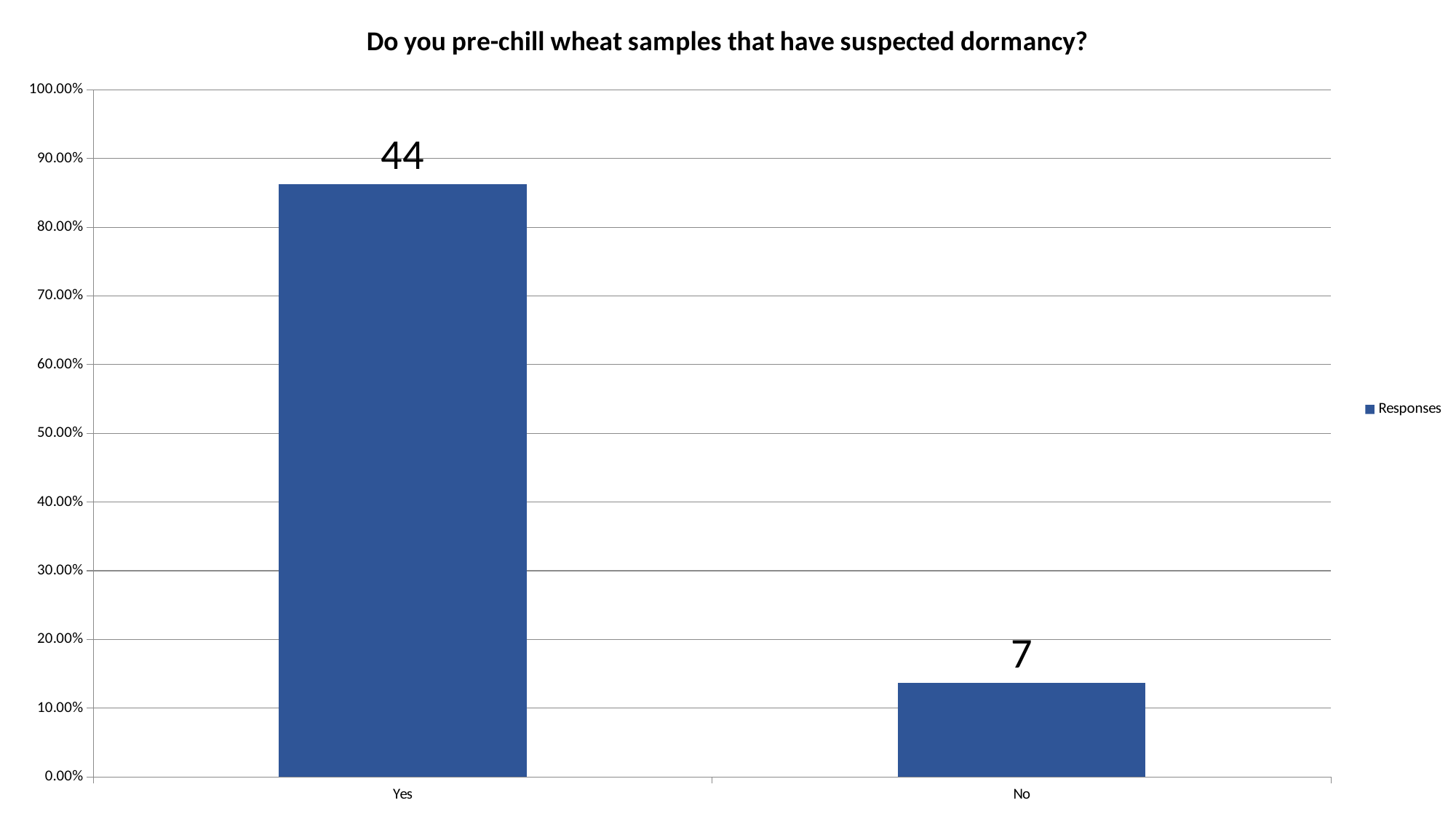
Which bar is taller, Yes or No? Yes How many categories are shown on the x axis? 2 What is the title of the chart? Do you pre-chill wheat samples that have suspected dormancy? What kind of chart is shown on the slide? bar chart How many series does the legend list? 1 Is the value for Yes greater or less than 80.00%? greater What is the difference between the data labels for Yes and No? 37 Which category has the highest bar? Yes Is the value for No greater or less than 20.00%? less What is the data label shown on the bar for No? 7 Which category has the lowest bar? No What is the data label shown on the bar for Yes? 44